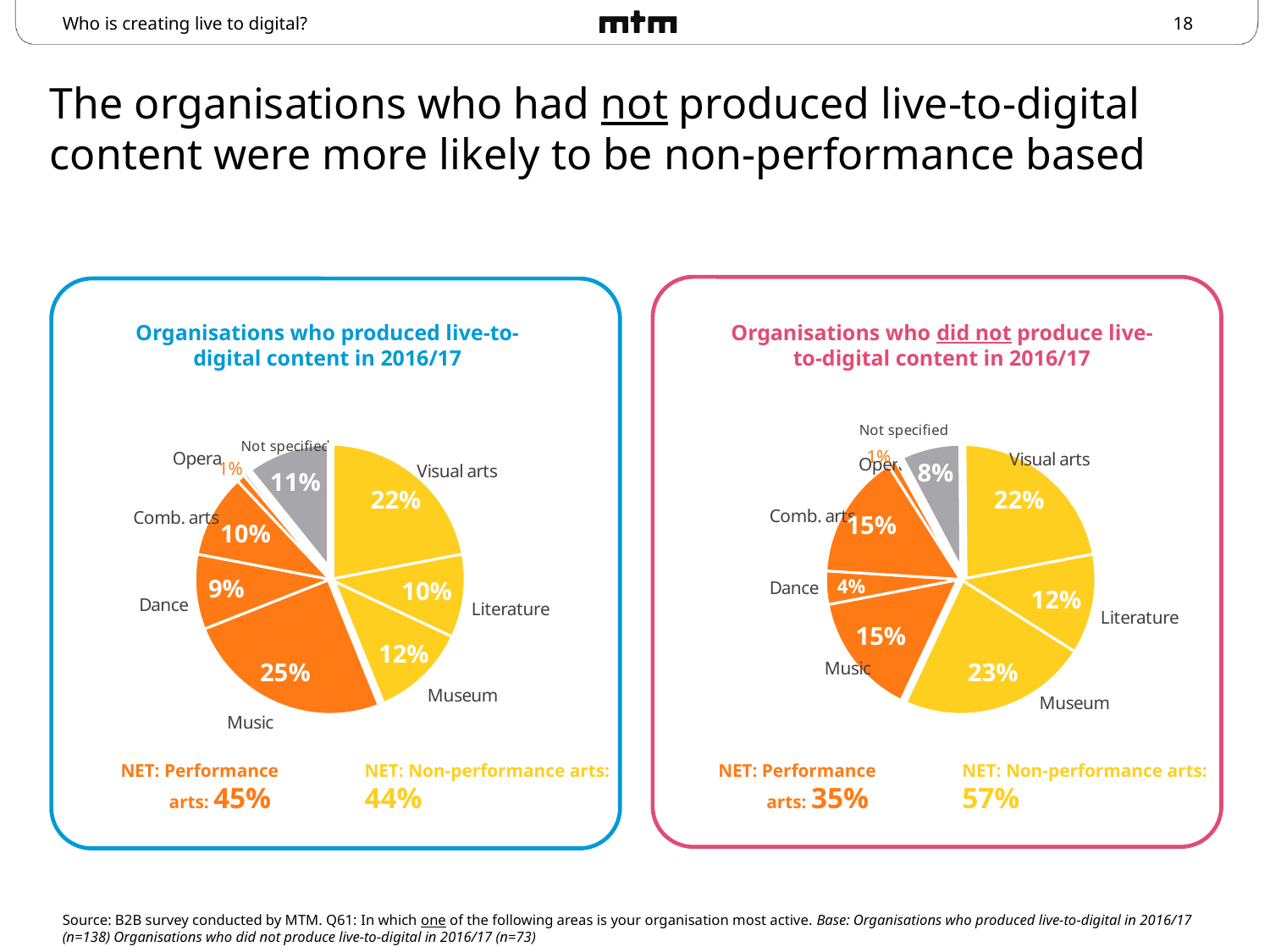
What type of chart is used on the right-hand side of the slide? Pie chart In the 'Organisations who did not produce live-to-digital content in 2016/17' chart, what share is Dance? 4% In the 'Organisations who produced live-to-digital content in 2016/17' chart, what share is Music? 25% In the 'Organisations who did not produce live-to-digital content in 2016/17' chart, what is the difference between the Museum and Dance shares? 19% How many categories are shown in the 'Organisations who produced live-to-digital content in 2016/17' pie chart? 8 In the 'Organisations who produced live-to-digital content in 2016/17' chart, which category has the smallest slice? Opera In the 'Organisations who did not produce live-to-digital content in 2016/17' chart, what share is Museum? 23% In the 'Organisations who produced live-to-digital content in 2016/17' chart, which category has the largest slice? Music In the 'Organisations who produced live-to-digital content in 2016/17' chart, which is larger, Literature or Museum? Museum In the 'Organisations who produced live-to-digital content in 2016/17' chart, what share is Not specified? 11% In the 'Organisations who did not produce live-to-digital content in 2016/17' chart, which category has the largest slice? Museum What is the NET: Non-performance arts figure shown under the 'Organisations who did not produce live-to-digital content in 2016/17' chart? 57%